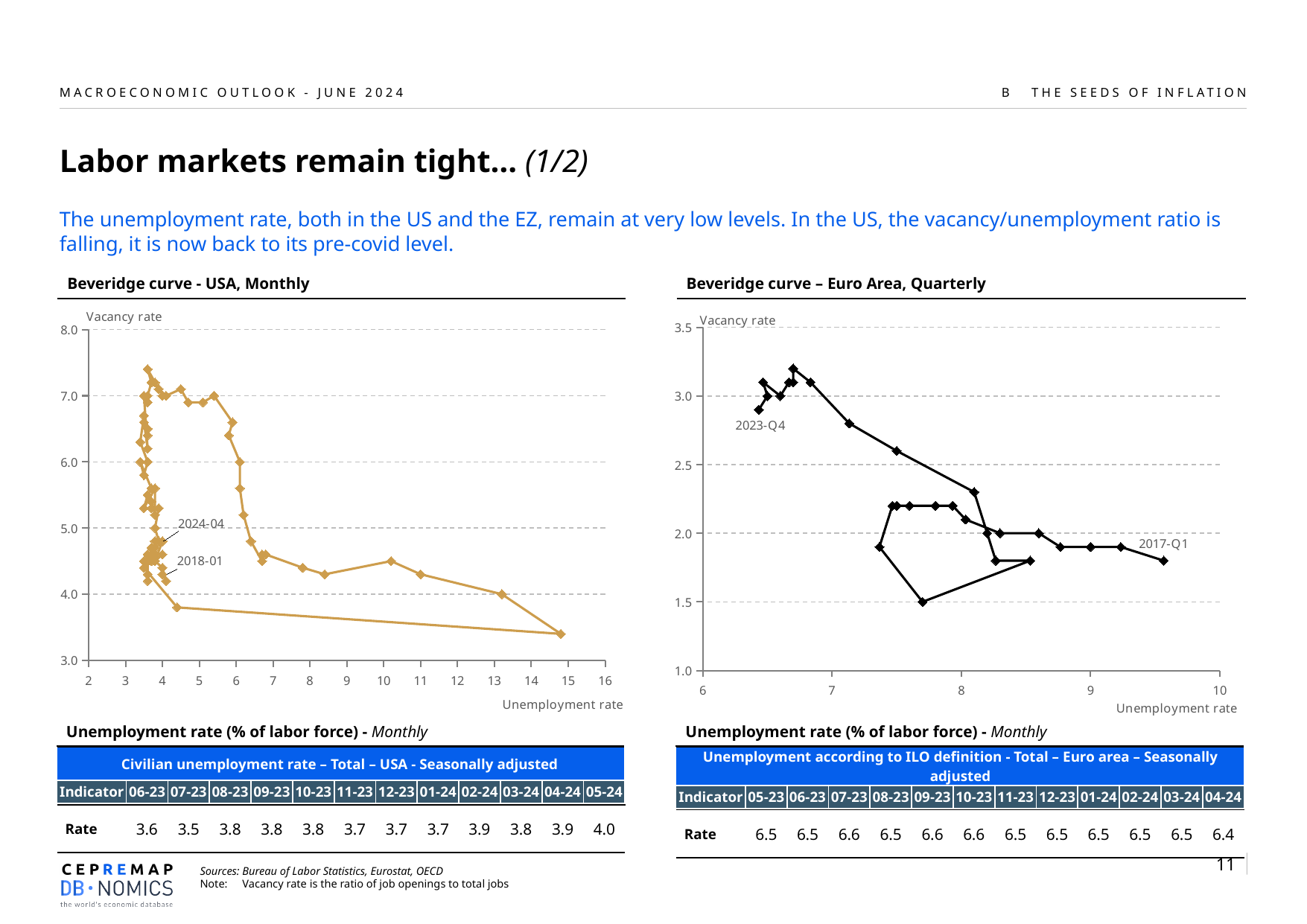
In the 'Beveridge curve - USA, Monthly' chart, which two dates are annotated on the curve? 2024-04 and 2018-01 In the 'Beveridge curve - USA, Monthly' chart, is the unemployment rate of the point with the lowest vacancy rate greater or less than 14? greater In the 'Beveridge curve – Euro Area, Quarterly' chart, is the highest vacancy rate reached greater or less than 3.0? greater In the 'Beveridge curve - USA, Monthly' chart, is the highest vacancy rate reached greater or less than 7.0? greater In the 'Beveridge curve - USA, Monthly' chart, what is the label of the vertical axis? Vacancy rate In the 'Beveridge curve - USA, Monthly' chart, what is the label of the horizontal axis? Unemployment rate What kind of chart is the 'Beveridge curve - USA, Monthly' chart? scatter chart with connected points